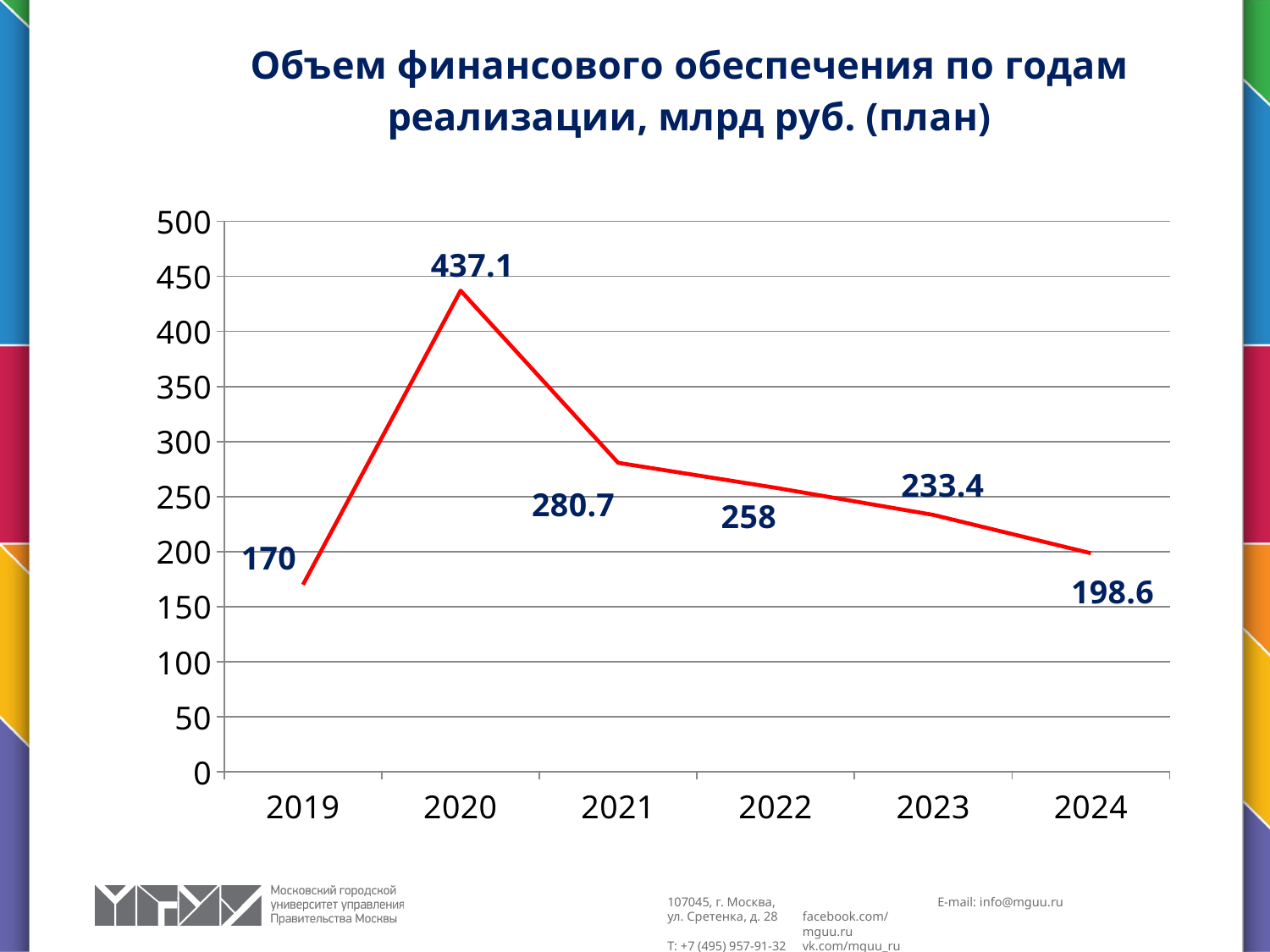
What is the difference between the values for 2020 and 2021? 156.4 What is the value for 2019? 170 Which year has the lowest value? 2019 Which year has the highest value? 2020 What is the difference between the values for 2023 and 2024? 34.8 Which is larger, the value for 2021 or the value for 2022? 2021 What kind of chart is shown on the slide? line chart How many years are plotted on the x axis? 6 What is the value for 2022? 258 What is the value for 2024? 198.6 What is the value for 2020? 437.1 Is the value for 2023 greater or less than 250? less